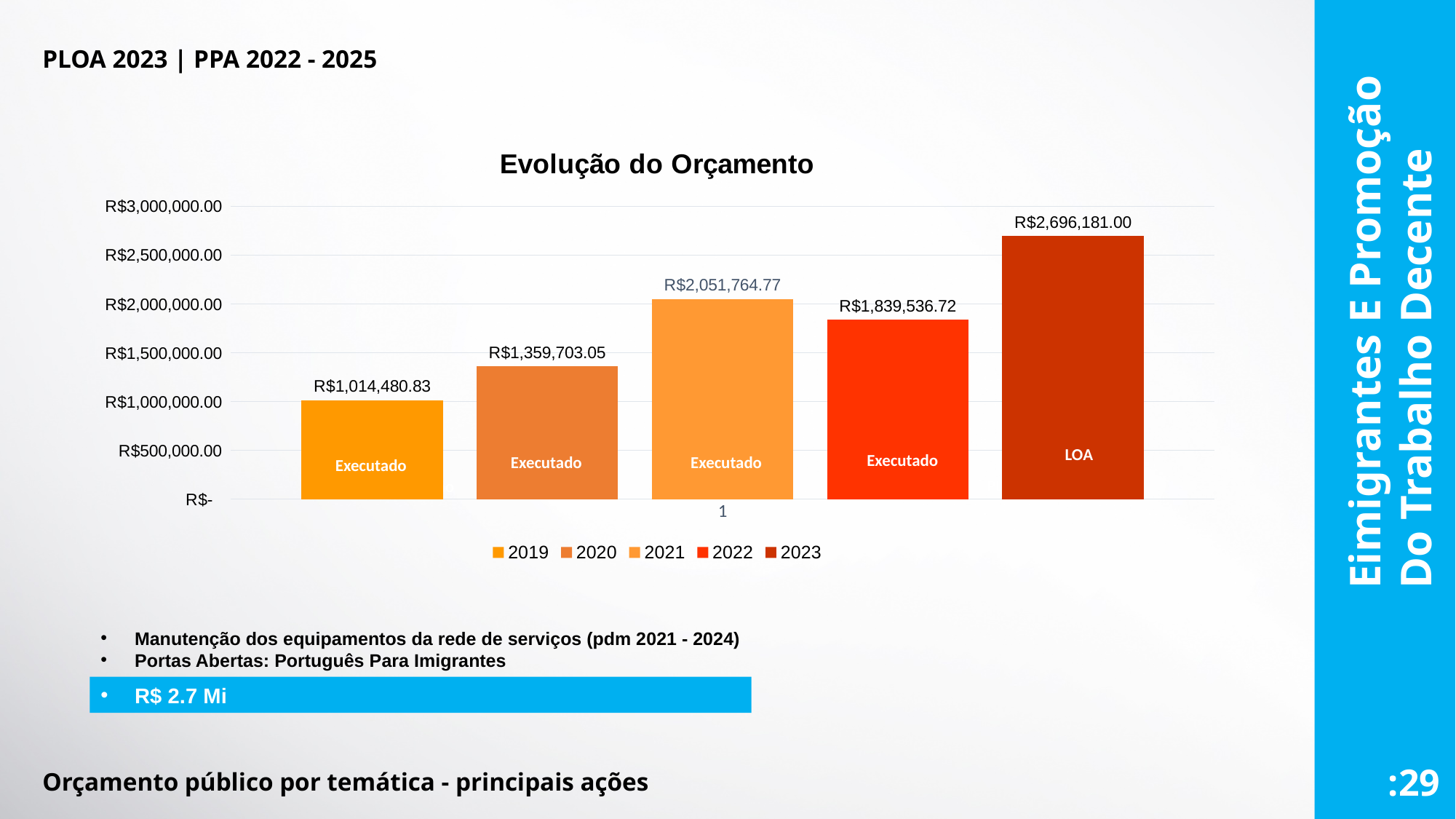
Which bar in the Evolução do Orçamento chart is labelled LOA rather than Executado? 2023 What is the value for 2019 in the Evolução do Orçamento chart? R$1,014,480.83 What is the difference between the 2023 value and the 2022 value in the Evolução do Orçamento chart? R$856,644.28 What is the value for 2021 in the Evolução do Orçamento chart? R$2,051,764.77 Which is larger in the Evolução do Orçamento chart, the 2021 value or the 2022 value? 2021 Which year has the highest value in the Evolução do Orçamento chart? 2023 Is the value for 2022 in the Evolução do Orçamento chart greater or less than R$2,000,000.00? less What is the difference between the 2020 value and the 2019 value in the Evolução do Orçamento chart? R$345,222.22 How many series does the legend of the Evolução do Orçamento chart list? 5 Which year has the lowest value in the Evolução do Orçamento chart? 2019 What kind of chart is Evolução do Orçamento? bar chart What is the value for 2023 (LOA) in the Evolução do Orçamento chart? R$2,696,181.00